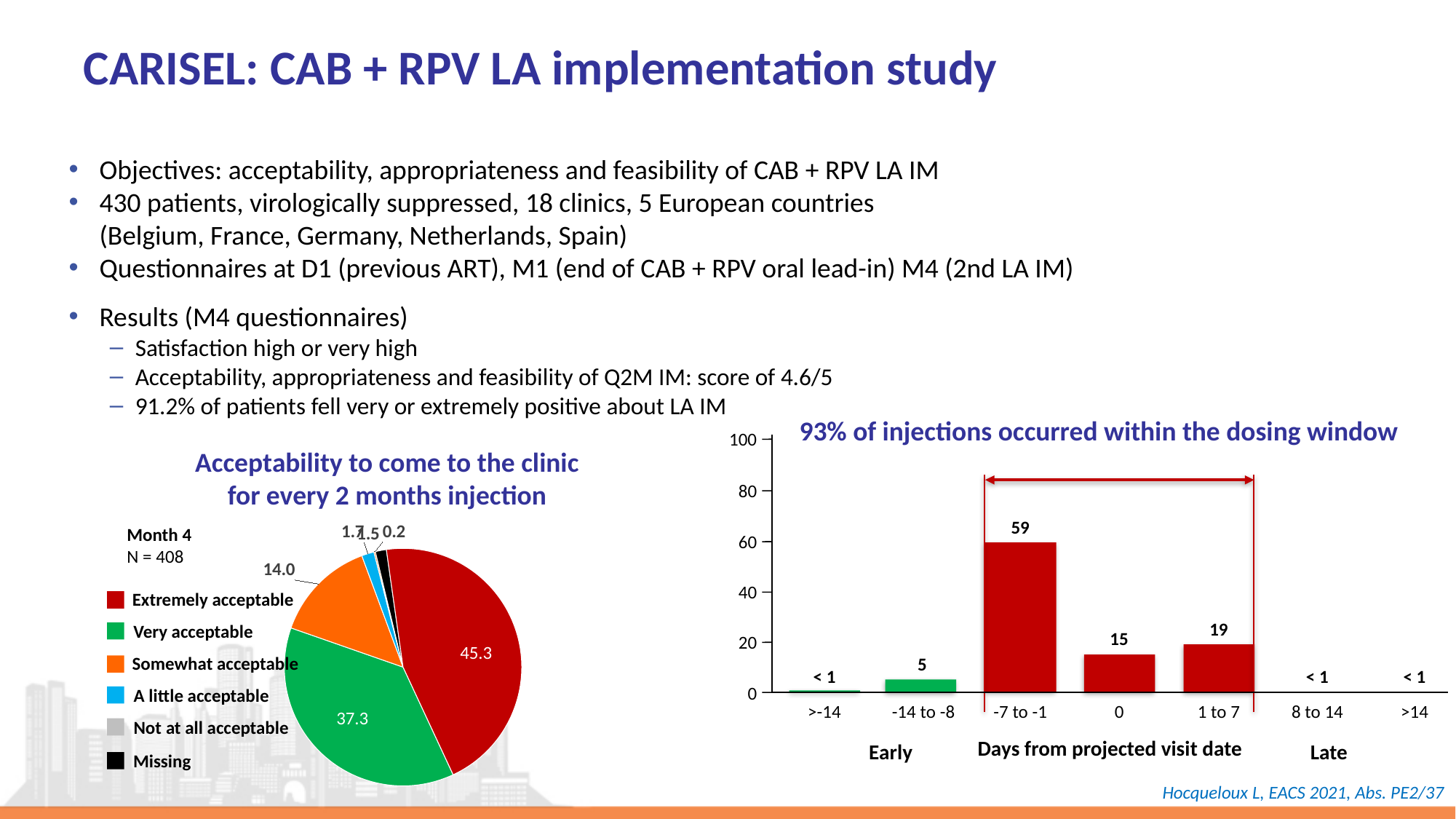
In the pie chart 'Acceptability to come to the clinic for every 2 months injection', what is the value for 'Somewhat acceptable'? 14.0 In the pie chart 'Acceptability to come to the clinic for every 2 months injection', what is the difference between the 'Extremely acceptable' and 'Very acceptable' values? 8.0 In the chart '93% of injections occurred within the dosing window', what is the value for '-14 to -8' days? 5 What kind of chart is '93% of injections occurred within the dosing window'? Bar chart In the pie chart 'Acceptability to come to the clinic for every 2 months injection', which category has the largest slice? Extremely acceptable In the chart '93% of injections occurred within the dosing window', what is the value for '1 to 7' days? 19 In the pie chart 'Acceptability to come to the clinic for every 2 months injection', what is the value for 'Extremely acceptable'? 45.3 In the chart '93% of injections occurred within the dosing window', which of '0' or '1 to 7' days has the larger value? 1 to 7 In the pie chart 'Acceptability to come to the clinic for every 2 months injection', what is the N shown for Month 4? 408 In the chart '93% of injections occurred within the dosing window', what is the value for '-7 to -1' days? 59 In the pie chart 'Acceptability to come to the clinic for every 2 months injection', what is the value for 'Very acceptable'? 37.3 In the pie chart 'Acceptability to come to the clinic for every 2 months injection', how many categories does the legend list? 6